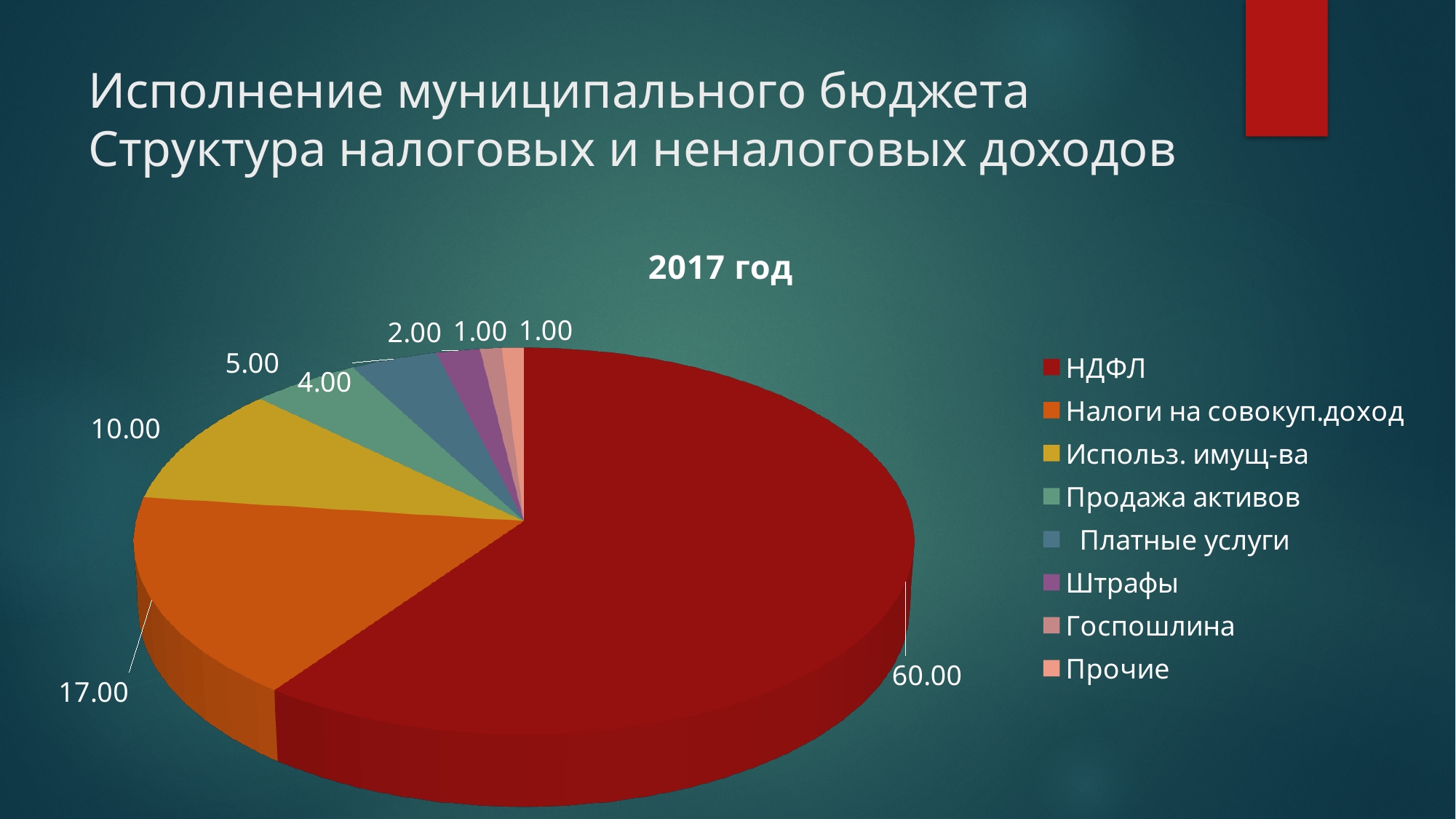
What is the value for Налоги на совокуп.доход? 17.00 What is the value for Продажа активов? 5.00 Which is larger, the value for Использ. имущ-ва or the value for Платные услуги? Использ. имущ-ва What is the value for НДФЛ? 60.00 How many categories does the legend of the pie chart list? 8 Which category has the largest slice of the pie? НДФЛ What is the difference between the values for НДФЛ and Налоги на совокуп.доход? 43.00 What kind of chart is shown on the slide? Pie chart What is the title of the chart? 2017 год What colour is the slice for Налоги на совокуп.доход? Orange What is the value for Штрафы? 2.00 What is the value for Использ. имущ-ва? 10.00